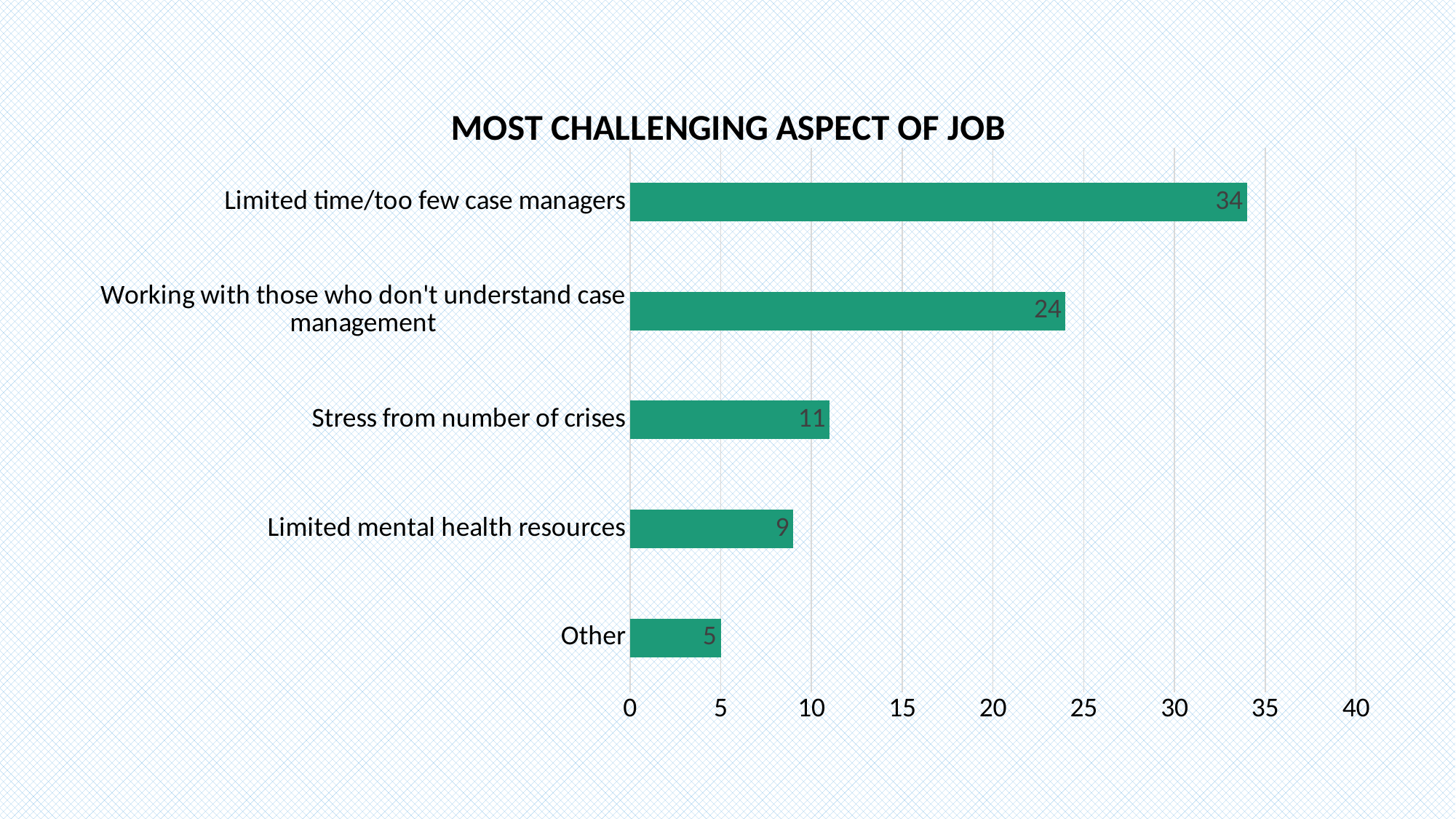
Which is larger: the value for "Stress from number of crises" or the value for "Limited mental health resources"? Stress from number of crises What is the title of the chart? MOST CHALLENGING ASPECT OF JOB What is the difference between the values for "Limited time/too few case managers" and "Working with those who don't understand case management"? 10 Which category has the lowest value? Other How many categories are shown in the chart? 5 What kind of chart is shown on the slide? Bar chart What is the value for "Limited mental health resources"? 9 What is the value for "Working with those who don't understand case management"? 24 What is the value for "Other"? 5 What is the value for "Limited time/too few case managers"? 34 Which category has the highest value? Limited time/too few case managers What is the value for "Stress from number of crises"? 11